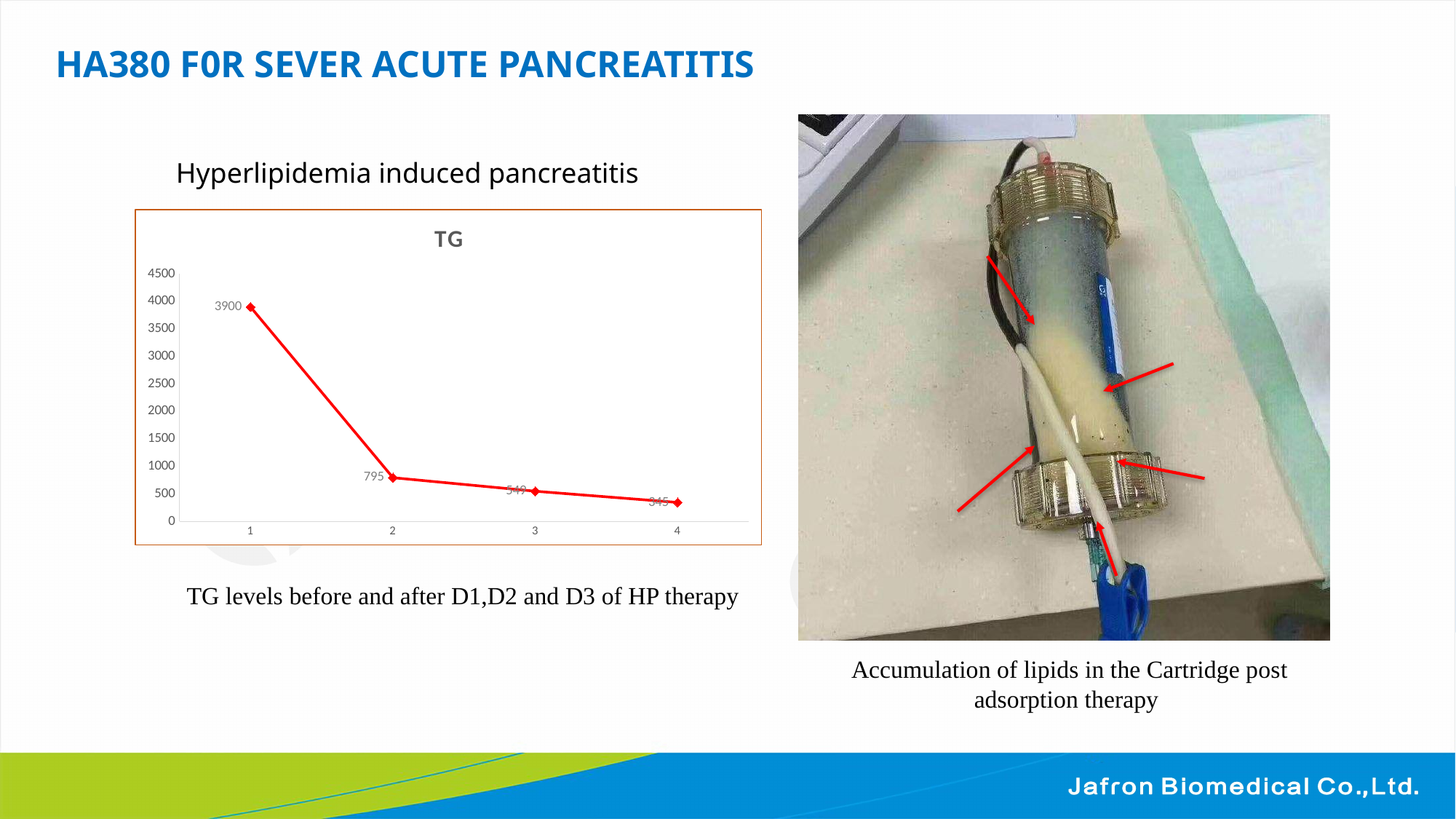
What is the TG value at point 2? 795 Do the TG values rise or fall from point 1 to point 4? fall Which point has the lowest TG value? 4 What type of chart is the TG chart? line chart Is the TG value at point 4 greater or less than 500? less How many data points are plotted on the TG chart? 4 What is the title of the chart? TG Which is larger, the TG value at point 2 or at point 3? point 2 What is the difference between the TG values at point 1 and point 2? 3105 Which point has the highest TG value? 1 What is the TG value at point 1? 3900 Is the TG value at point 3 greater or less than 1000? less